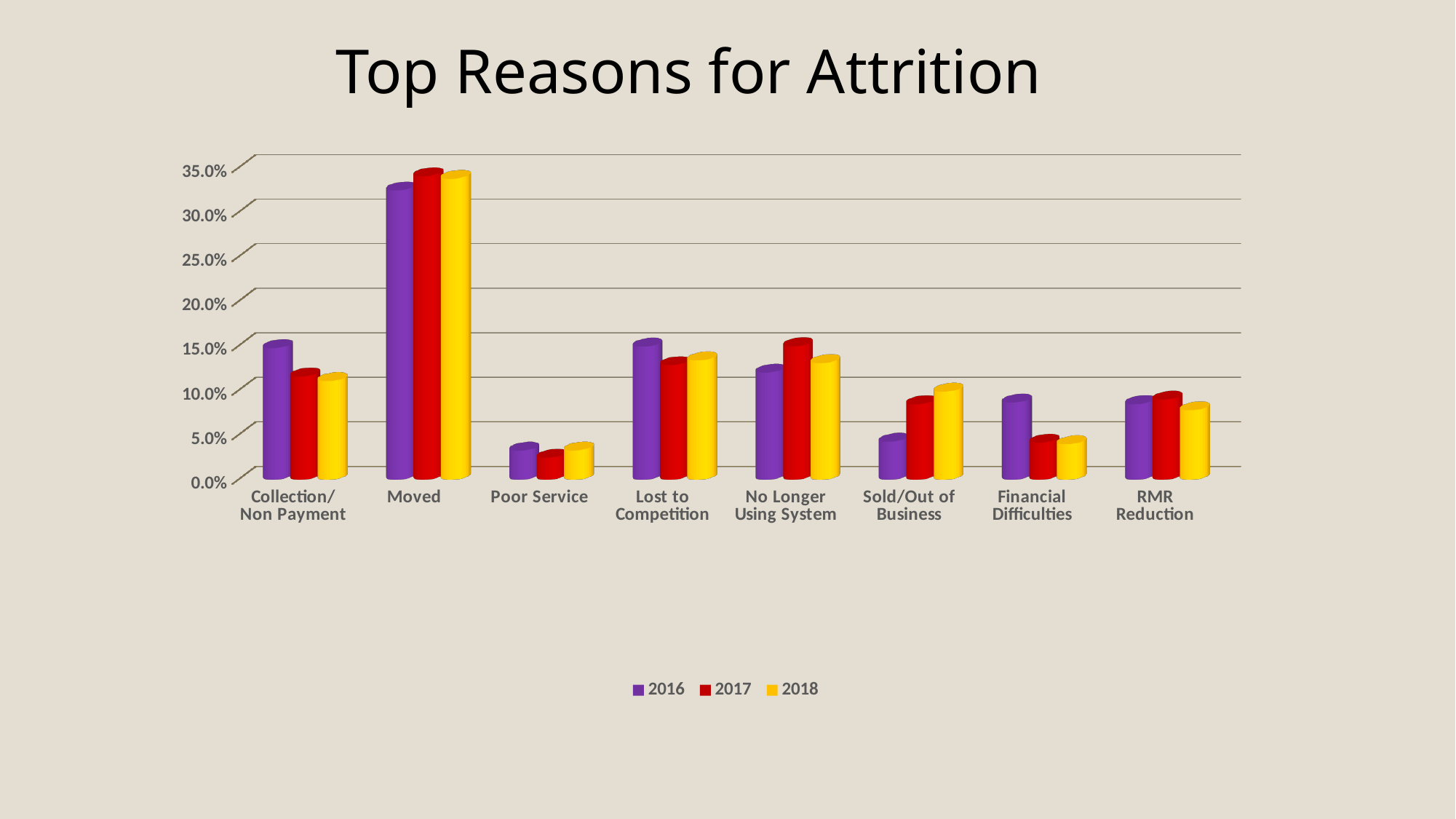
Is the 2016 value for Collection/Non Payment greater or less than 10.0%? greater For Sold/Out of Business, which year has the larger value, 2016 or 2018? 2018 Which attrition reason has the highest values across all three years? Moved Do the values for Sold/Out of Business rise or fall from 2016 to 2018? rise Which attrition reason has the lowest values across all three years? Poor Service What colour represents the 2017 series in the chart? red Is the 2016 value for Poor Service greater or less than 5.0%? less Is the 2017 value for Moved greater or less than 30.0%? greater How many attrition reasons (categories) are shown on the x axis? 8 How many series does the legend list? 3 What kind of chart is shown on the slide? bar chart For Financial Difficulties, which year has the larger value, 2016 or 2017? 2016